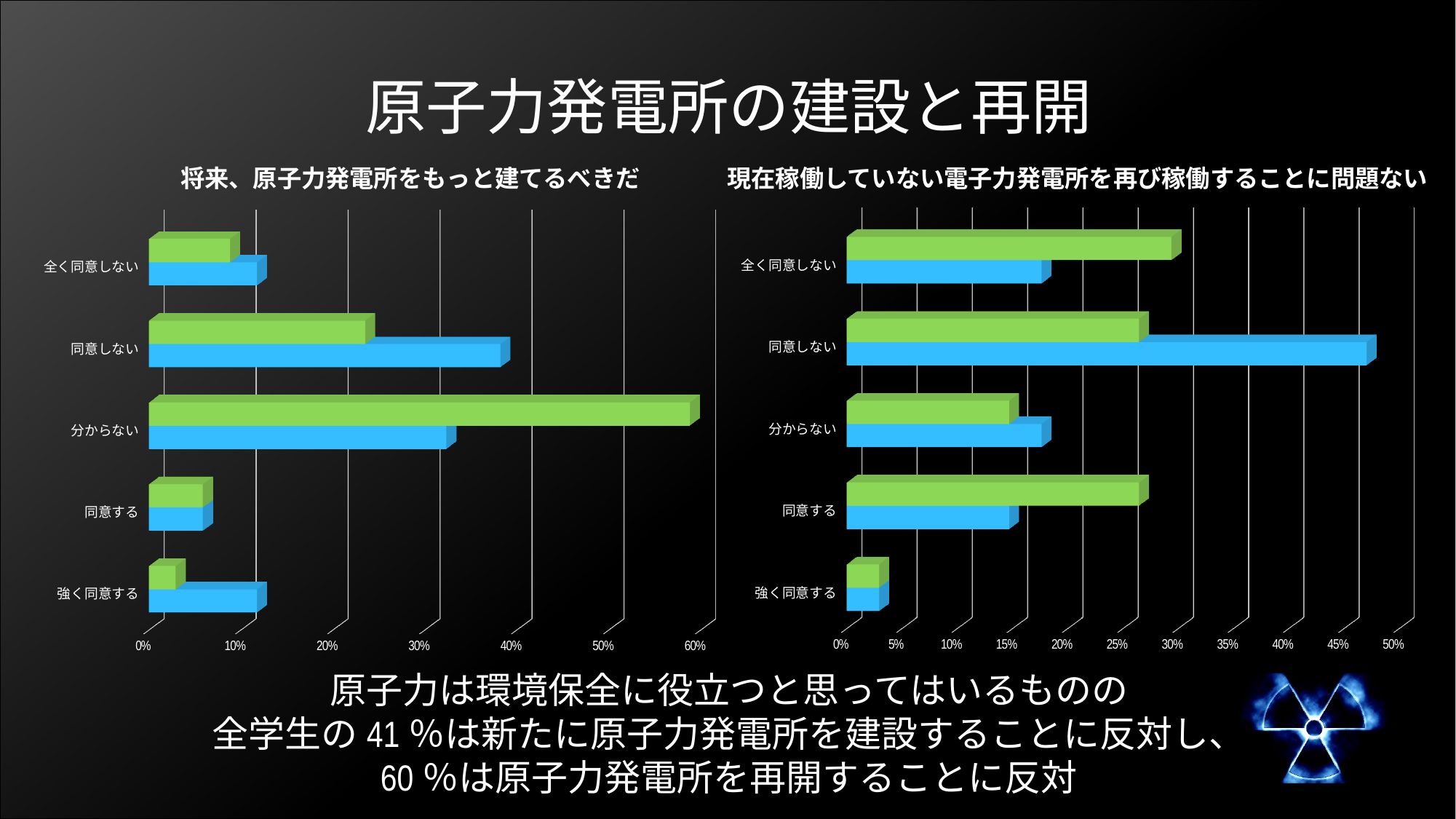
How many categories are shown on the right chart titled 「現在稼働していない電子力発電所を再び稼働することに問題ない」? 5 In the right chart 「現在稼働していない電子力発電所を再び稼働することに問題ない」, is the green bar for 強く同意する greater or less than 10%? less In the left chart 「将来、原子力発電所をもっと建てるべきだ」, which category has the shortest green bar? 強く同意する In the right chart 「現在稼働していない電子力発電所を再び稼働することに問題ない」, which category has the longest blue bar? 同意しない In the left chart 「将来、原子力発電所をもっと建てるべきだ」, is the blue bar for 同意しない greater or less than 30%? greater In the left chart 「将来、原子力発電所をもっと建てるべきだ」, is the green bar for 分からない greater or less than 50%? greater In the left chart 「将来、原子力発電所をもっと建てるべきだ」, which category has the longest green bar? 分からない In the left chart 「将来、原子力発電所をもっと建てるべきだ」, which is longer for 同意しない: the green bar or the blue bar? the blue bar In the right chart 「現在稼働していない電子力発電所を再び稼働することに問題ない」, which category has the shortest blue bar? 強く同意する What kind of chart is the left chart titled 「将来、原子力発電所をもっと建てるべきだ」? bar chart What is the title of the slide containing the two charts? 原子力発電所の建設と再開